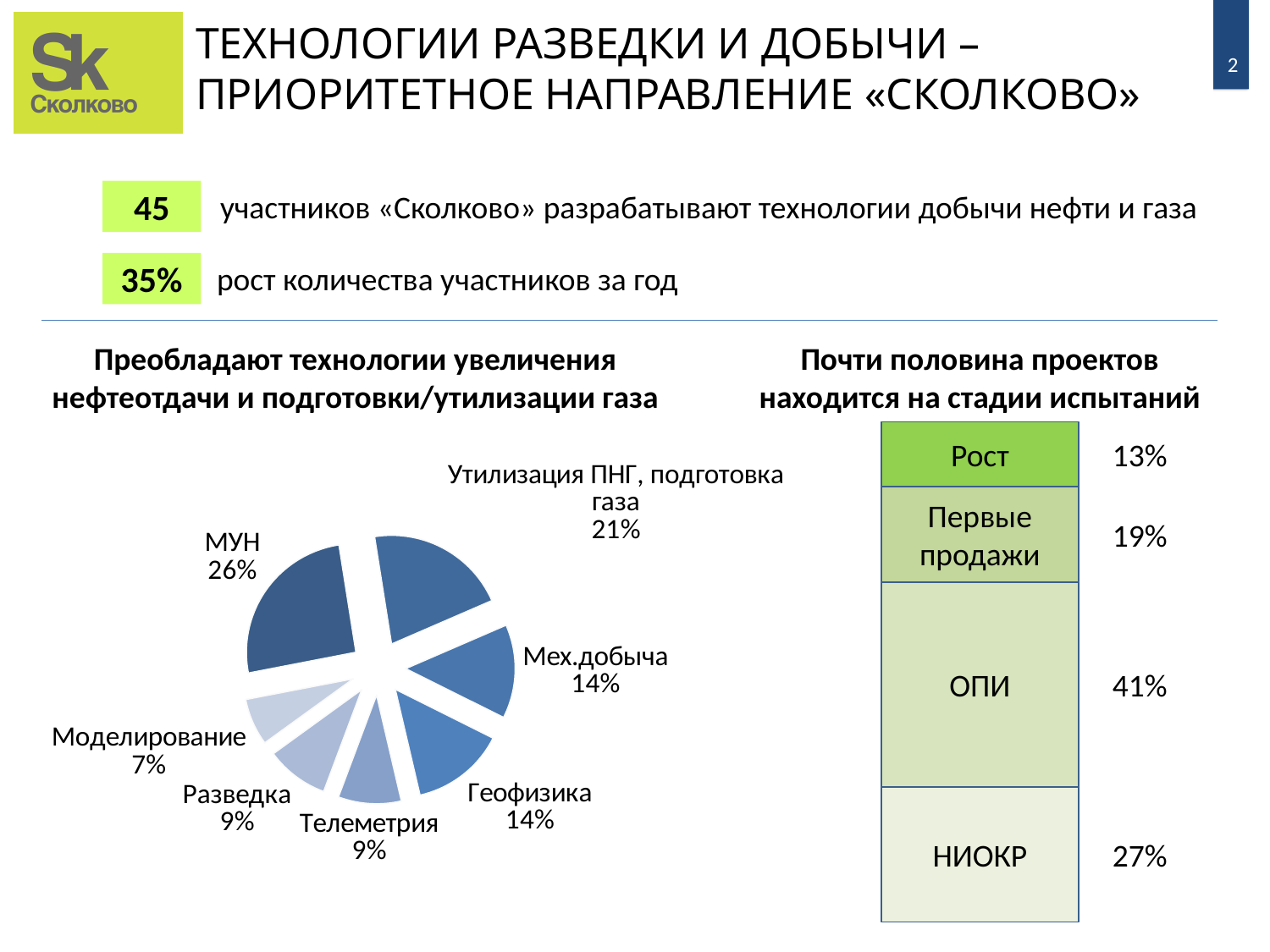
What type of chart is shown on the left of the slide? Pie chart In the stacked bar on the right, what is the value for НИОКР? 27% In the pie chart on the left, what share does Утилизация ПНГ, подготовка газа have? 21% In the pie chart on the left, which category has the largest share? МУН In the pie chart on the left, what share does МУН have? 26% In the pie chart on the left, what is the difference in percentage points between МУН and Моделирование? 19 In the pie chart on the left, how many categories are shown? 7 In the pie chart on the left, which category has the smallest share? Моделирование In the stacked bar on the right, how many segments are there? 4 In the stacked bar on the right, which stage has the smallest share? Рост In the pie chart on the left, which is larger: Мех.добыча or Телеметрия? Мех.добыча In the stacked bar on the right, what is the value for ОПИ? 41%